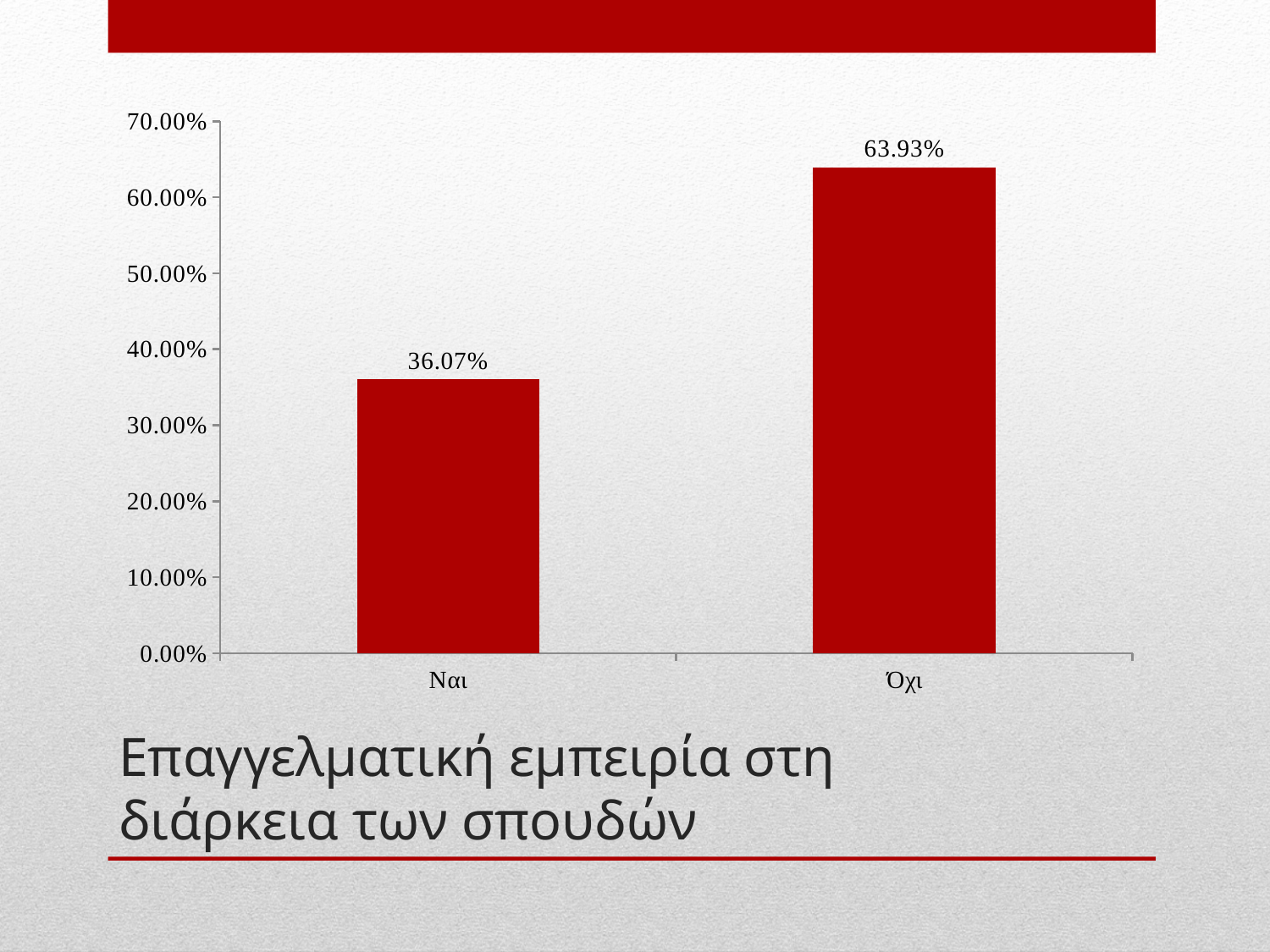
What is the value for Ναι? 36.07% Is the value for Ναι greater or less than 40.00%? less What kind of chart is shown on the slide? bar chart What is the value for Όχι? 63.93% Which category has the highest value? Όχι What colour are the bars in the chart? dark red Which category has the lowest value? Ναι What is the difference between the values for Όχι and Ναι? 27.86% What is the title text shown below the chart? Επαγγελματική εμπειρία στη διάρκεια των σπουδών How many categories are shown on the x axis? 2 Which is larger, the value for Ναι or the value for Όχι? Όχι Is the value for Όχι greater or less than 60.00%? greater